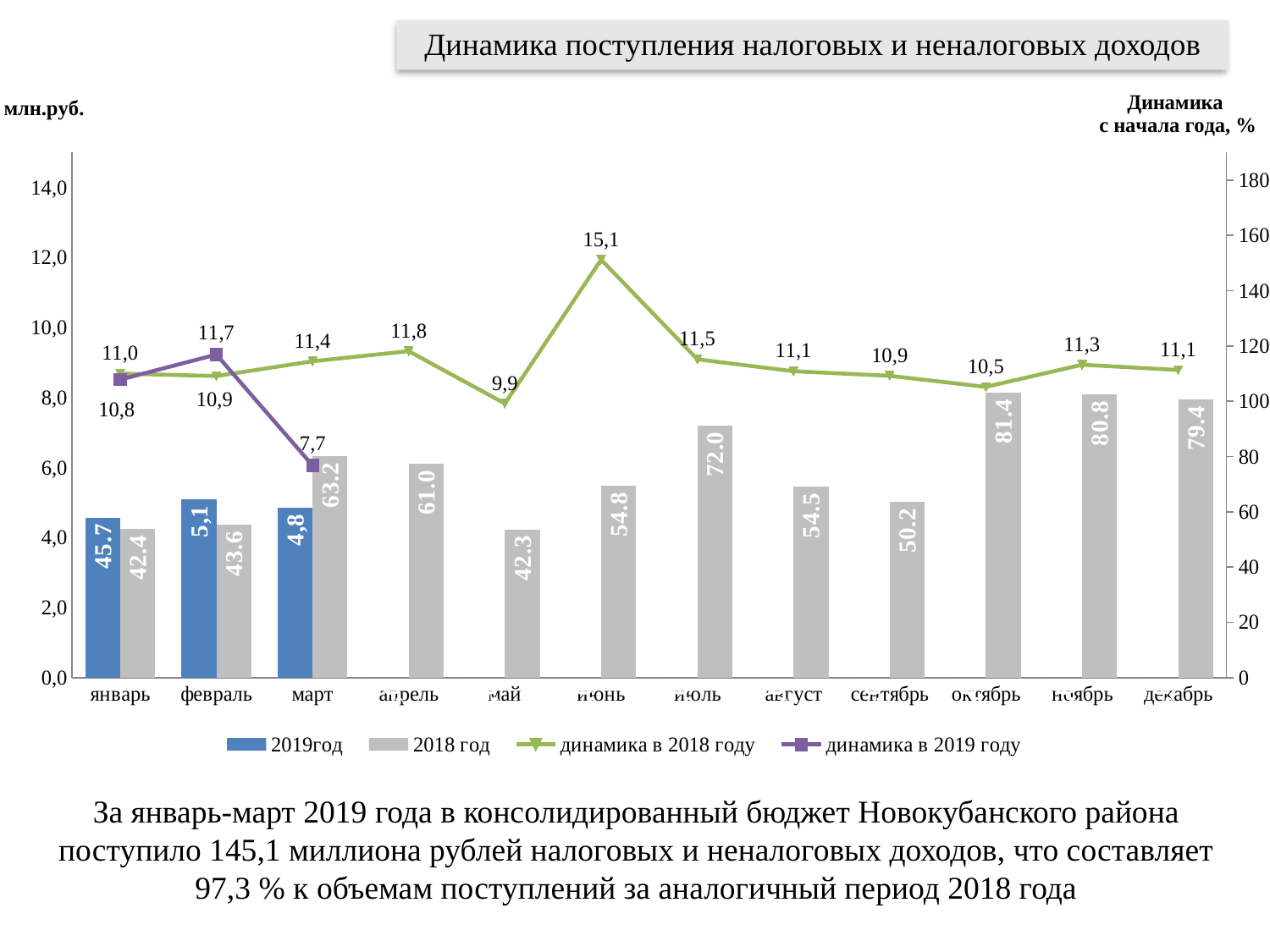
Which month has the highest 2018 год bar? октябрь What value is labelled on the 'динамика в 2019 году' line for март? 7,7 What is the difference between the 2018 год bars for октябрь and ноябрь? 0.6 For январь, which bar is larger: 2019год or 2018 год? 2019год What is the difference between the 'динамика в 2019 году' values for февраль and март? 4,0 What is the value of the 2018 год bar for июль? 72.0 How many series does the legend list? 4 What value is labelled on the 'динамика в 2018 году' line for апрель? 11,8 Which month has the highest point on the 'динамика в 2018 году' line? июнь How many months are shown on the x axis? 12 Which month has the lowest point on the 'динамика в 2018 году' line? май What kind of chart is shown on the slide? Combined bar and line chart